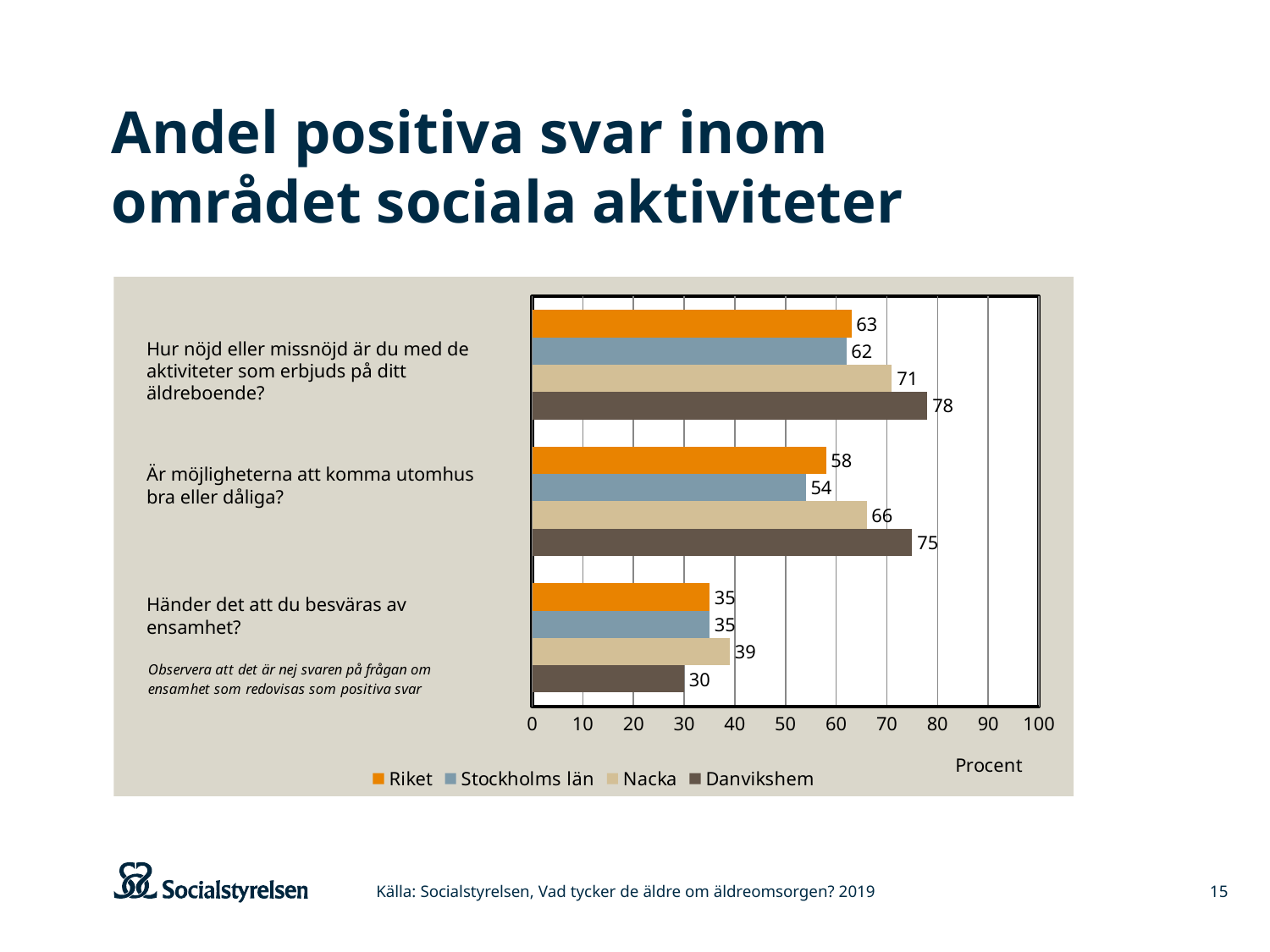
What unit is shown on the horizontal axis of the chart? Procent What is the value for Danvikshem on the question "Hur nöjd eller missnöjd är du med de aktiviteter som erbjuds på ditt äldreboende?"? 78 What is the value for Nacka on the question "Händer det att du besväras av ensamhet?"? 39 Which series has the highest value on the question "Är möjligheterna att komma utomhus bra eller dåliga?"? Danvikshem What is the value for Stockholms län on the question "Är möjligheterna att komma utomhus bra eller dåliga?"? 54 Which is larger on the question "Är möjligheterna att komma utomhus bra eller dåliga?": the value for Nacka or the value for Riket? Nacka What kind of chart is shown on the slide? Bar chart Which series has the lowest value on the question "Händer det att du besväras av ensamhet?"? Danvikshem How many series does the legend list? 4 What is the difference between the Danvikshem and Riket values on the question "Hur nöjd eller missnöjd är du med de aktiviteter som erbjuds på ditt äldreboende?"? 15 How many questions (categories) are shown on the chart? 3 Which series is shown in orange in the legend? Riket